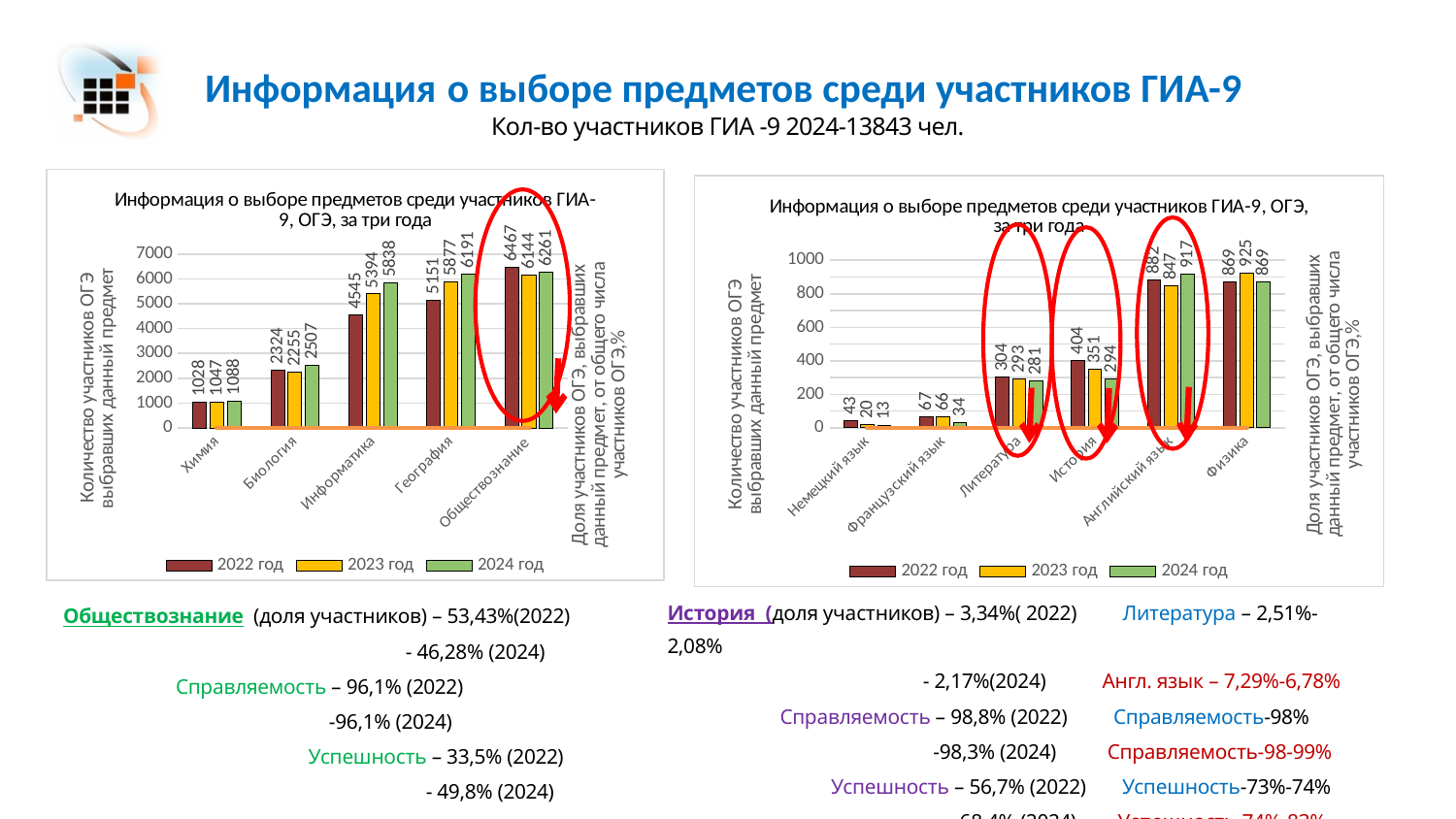
In the left chart, how many subjects are shown on the x axis? 5 In the left chart, which subject has the lowest value for 2024 год? Химия In the left chart, how many participants chose Информатика in 2024 год? 5838 In the right chart, what is the value for История in 2023 год? 351 In the right chart, what is the value for Английский язык in 2024 год? 917 In the left chart, what is the difference between the 2024 год and 2022 год values for География? 1040 In the right chart, which subject has the lowest value for 2024 год? Немецкий язык In the left chart, what is the value for Биология in 2022 год? 2324 In the right chart, do the values for История rise or fall from 2022 год to 2024 год? fall In the left chart, which subject has the highest value for 2022 год? Обществознание In the right chart, which is larger for Физика: the 2023 год value or the 2022 год value? 2023 год How many series does the legend of the right chart list? 3